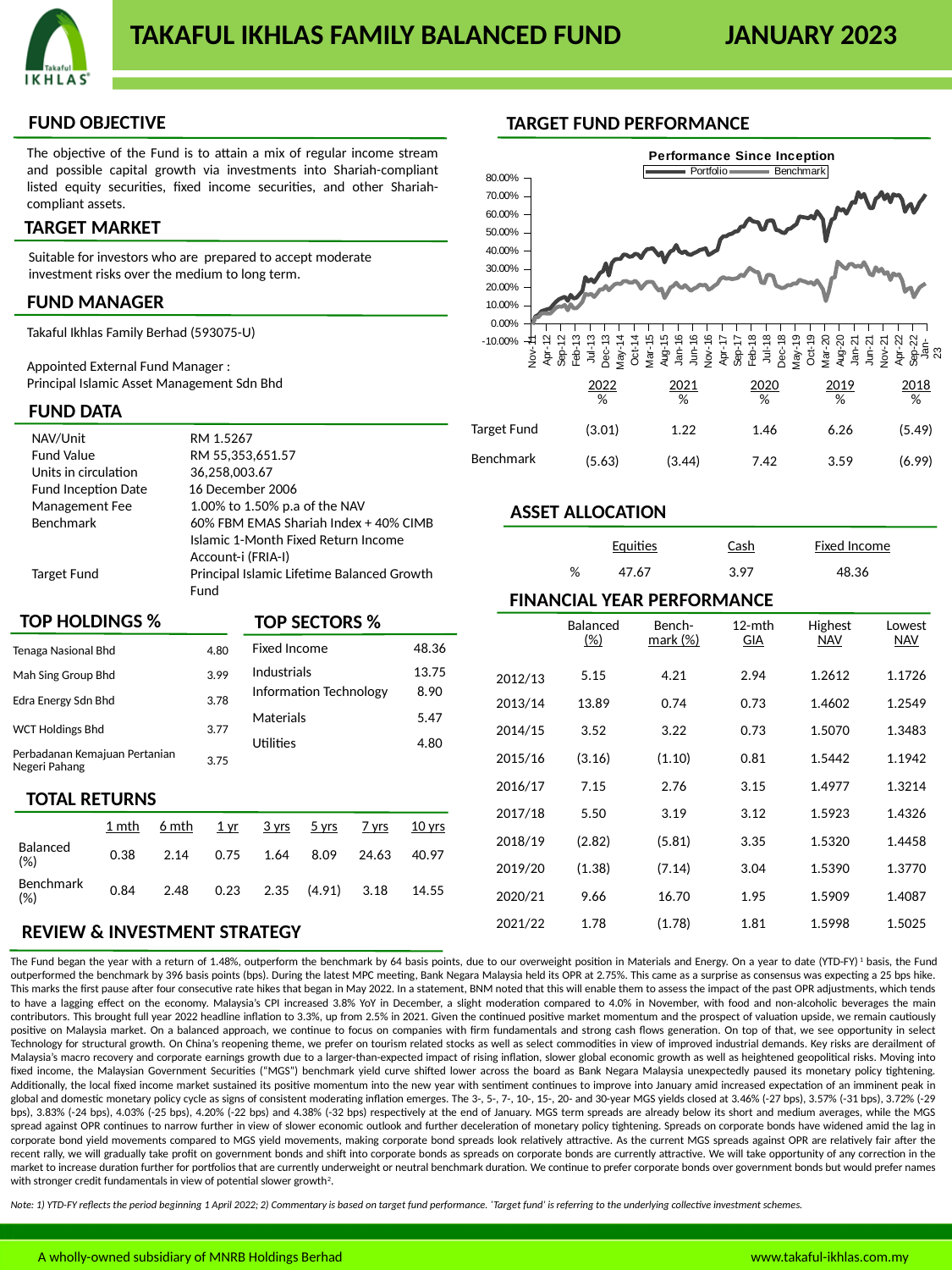
In the "Performance Since Inception" chart, is the Portfolio value at Jan-23 greater or less than 60.00%? greater In the "Performance Since Inception" chart, does the Portfolio line overall rise or fall from Nov-11 to Jan-23? rise What are the two series named in the legend of the "Performance Since Inception" chart? Portfolio and Benchmark What kind of chart is the "Performance Since Inception" chart? line chart In the "Performance Since Inception" chart, is the Benchmark value at Jan-23 greater or less than 30.00%? less How many series does the legend of the "Performance Since Inception" chart list? 2 In the "Performance Since Inception" chart, which series is higher at Jan-23, Portfolio or Benchmark? Portfolio In the "Performance Since Inception" chart, is the Portfolio value at Jan-23 greater or less than 80.00%? less What is the highest value shown on the y axis of the "Performance Since Inception" chart? 80.00% What is the title of the chart on the slide? Performance Since Inception